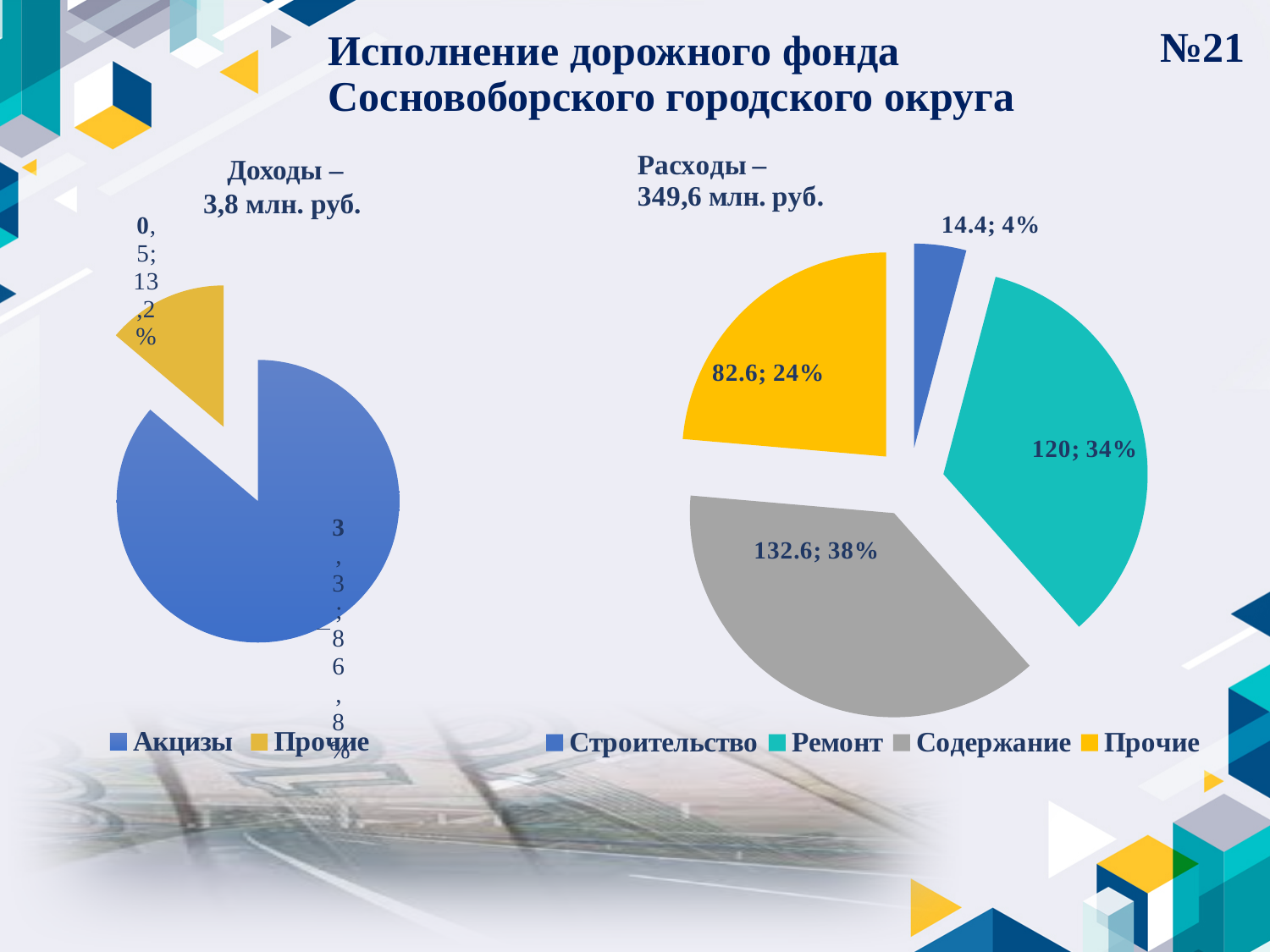
How many categories does the legend of the 'Расходы – 349,6 млн. руб.' chart list? 4 In the 'Расходы – 349,6 млн. руб.' chart, which category has the largest slice? Содержание In the 'Расходы – 349,6 млн. руб.' chart, which is larger: Прочие or Ремонт? Ремонт In the 'Доходы – 3,8 млн. руб.' chart on the left, which category has the largest slice? Акцизы In the 'Доходы – 3,8 млн. руб.' chart on the left, what share of the pie does Прочие take? 13,2% In the 'Расходы – 349,6 млн. руб.' chart, what value is shown for Строительство? 14.4; 4% In the 'Расходы – 349,6 млн. руб.' chart, what is the difference between the values for Содержание and Ремонт? 12.6 In the 'Расходы – 349,6 млн. руб.' chart, what value is shown for Содержание? 132.6; 38% In the 'Расходы – 349,6 млн. руб.' chart, which category has the smallest slice? Строительство In the 'Расходы – 349,6 млн. руб.' chart, what share of the pie does Прочие take? 24% What kind of chart is the 'Расходы – 349,6 млн. руб.' chart on the right? pie chart In the 'Расходы – 349,6 млн. руб.' chart, what value is shown for Ремонт? 120; 34%